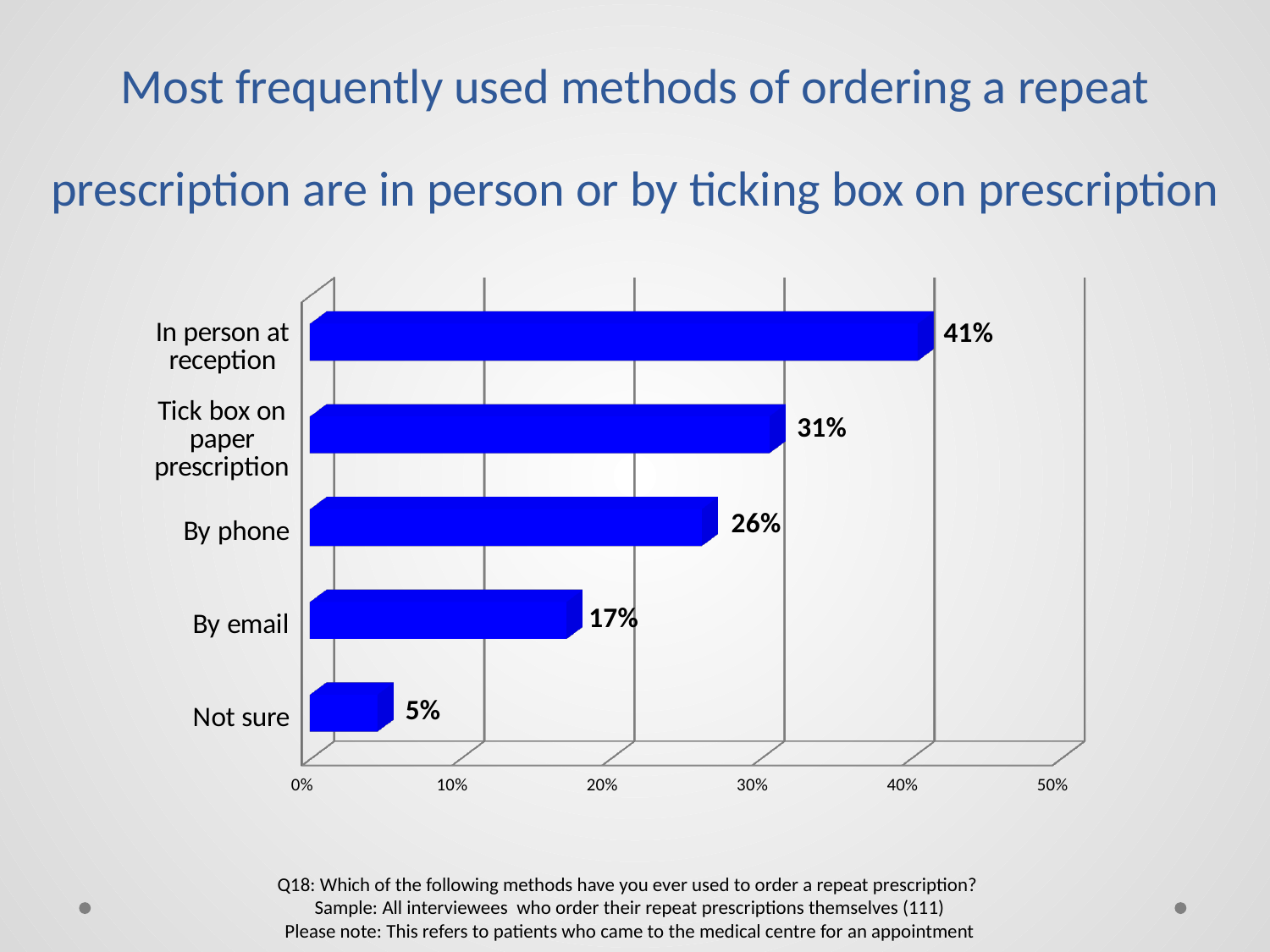
What type of chart is shown on the slide? Bar chart What is the difference between 'By phone' and 'By email'? 9% What percentage is shown for 'Not sure'? 5% Which method has the highest percentage? In person at reception What is the value shown for 'By phone'? 26% What is the difference between 'In person at reception' and 'Tick box on paper prescription'? 10% Which is larger, 'By email' or 'By phone'? By phone What is the maximum value shown on the x axis? 50% What percentage of respondents order a repeat prescription in person at reception? 41% Which category has the lowest value? Not sure How many categories are shown in the chart? 5 Is the value for 'Tick box on paper prescription' greater or less than 30%? greater